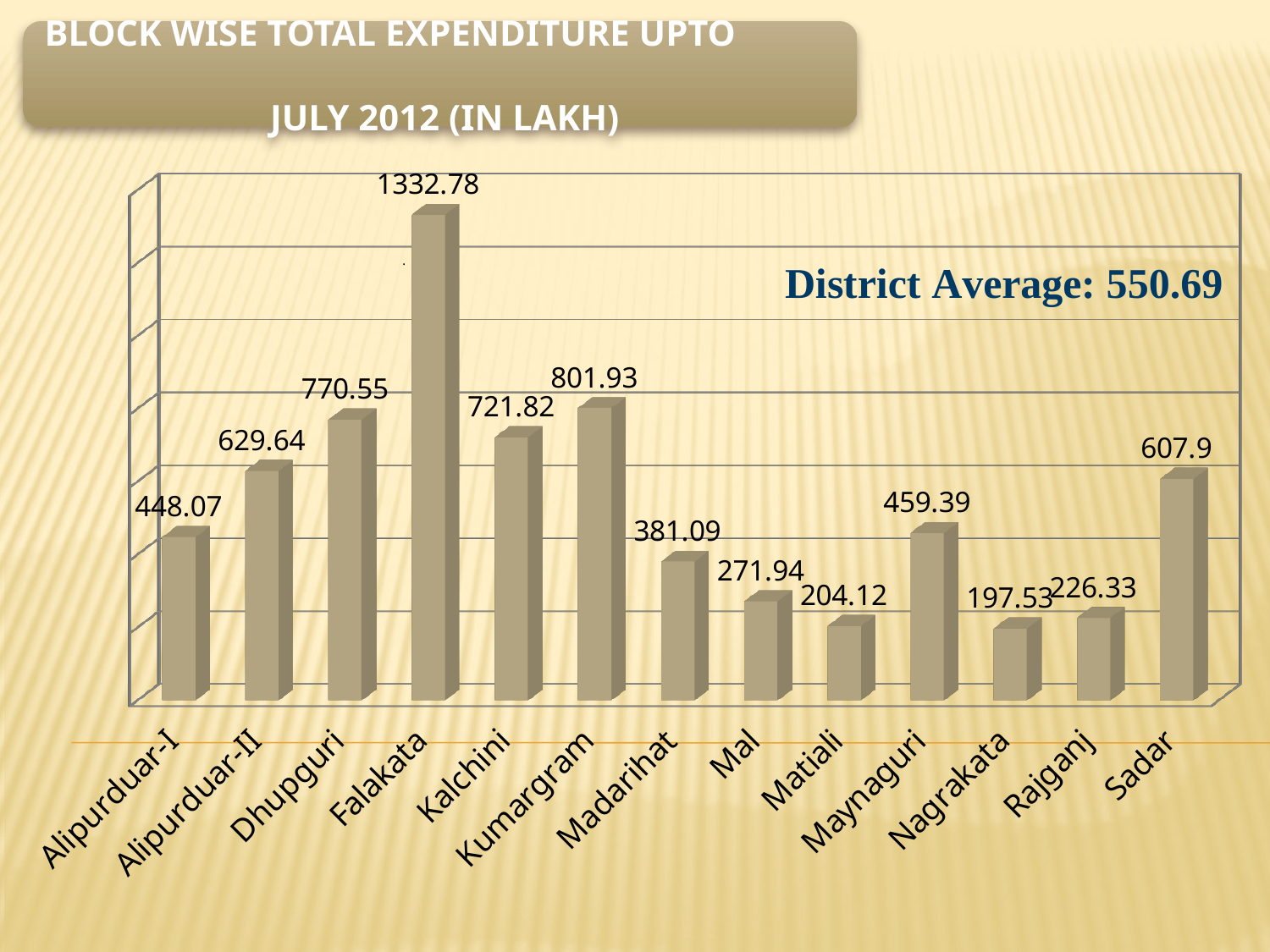
Which block has a higher expenditure, Dhupguri or Kalchini? Dhupguri What is the total expenditure for Sadar? 607.9 What is the total expenditure for Madarihat? 381.09 Which block has the highest total expenditure? Falakata What is the total expenditure for Maynaguri? 459.39 What kind of chart is shown on the slide? Bar chart What is the difference between the expenditure of Sadar and Alipurduar-I? 159.83 Which block has the lowest total expenditure? Nagrakata How many blocks are shown in the chart? 13 What is the total expenditure for Falakata? 1332.78 What district average is stated on the chart? 550.69 What is the difference between the expenditure of Falakata and Kumargram? 530.85